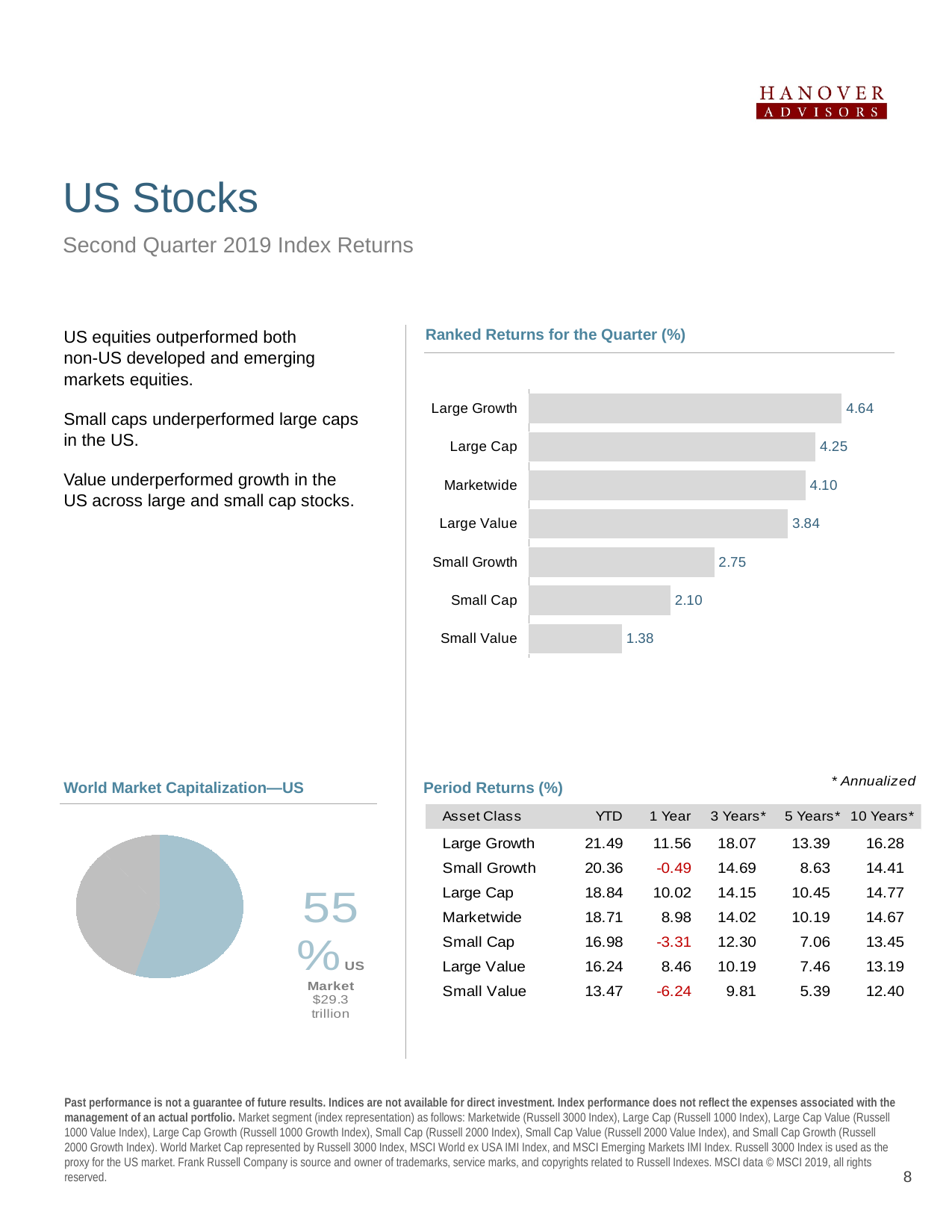
In the Ranked Returns for the Quarter (%) chart, which is larger, Small Growth or Large Value? Large Value In the Ranked Returns for the Quarter (%) chart, what is the value for Small Cap? 2.10 What kind of chart is the World Market Capitalization—US chart? Pie chart In the World Market Capitalization—US chart, what share of world market capitalization does the US represent? 55% How many categories are shown in the Ranked Returns for the Quarter (%) chart? 7 In the Ranked Returns for the Quarter (%) chart, what is the difference between Large Cap and Small Cap? 2.15 What kind of chart is the Ranked Returns for the Quarter (%) chart? Bar chart In the Ranked Returns for the Quarter (%) chart, what is the value for Marketwide? 4.10 In the Ranked Returns for the Quarter (%) chart, what is the difference between Large Value and Small Value? 2.46 In the Ranked Returns for the Quarter (%) chart, what is the value for Large Growth? 4.64 In the Ranked Returns for the Quarter (%) chart, which category has the lowest value? Small Value In the Ranked Returns for the Quarter (%) chart, which category has the highest value? Large Growth